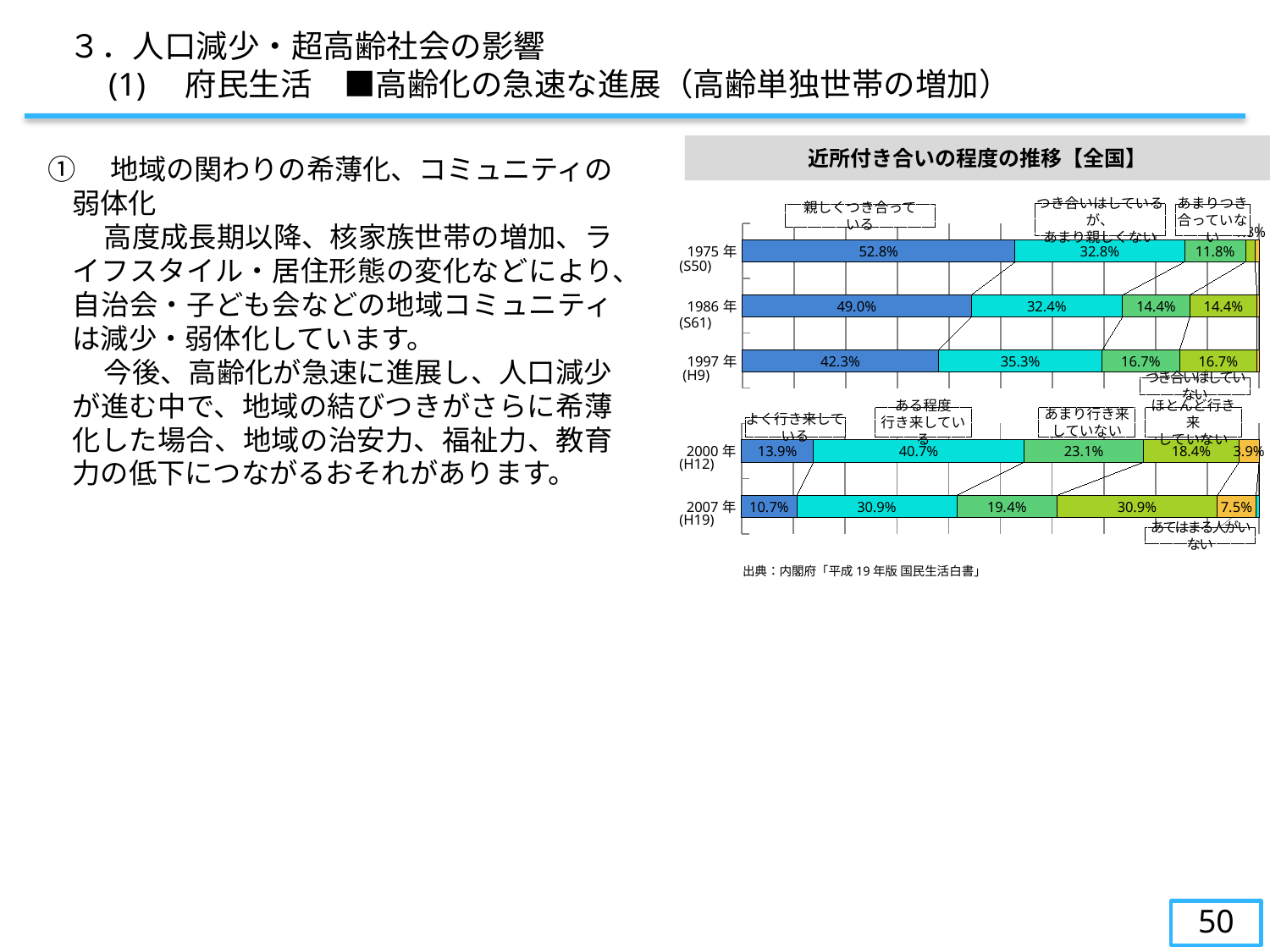
Which is larger: the first segment for 2000年(H12) or the first segment for 2007年(H19)? 2000年(H12) In the chart, what is the value of the first (leftmost) segment for 1997年(H9)? 42.3% Does the value of the first (leftmost) segment rise or fall from 1975年 to 1997年? fall In the chart, what is the value of the first (leftmost) segment for 2007年(H19)? 10.7% In the chart, what is the value of the first (leftmost) segment for 1975年(S50)? 52.8% What type of chart is shown on the slide? stacked bar chart In the chart, what is the value of the second segment for 1986年(S61)? 32.4% In the chart, what is the value of the third segment for 2000年(H12)? 23.1% What is the difference between the first segment value for 1975年(S50) (52.8%) and for 1997年(H9) (42.3%)? 10.5 percentage points What is the title of the chart on the slide? 近所付き合いの程度の推移【全国】 How many years (bars) are shown in the chart? 5